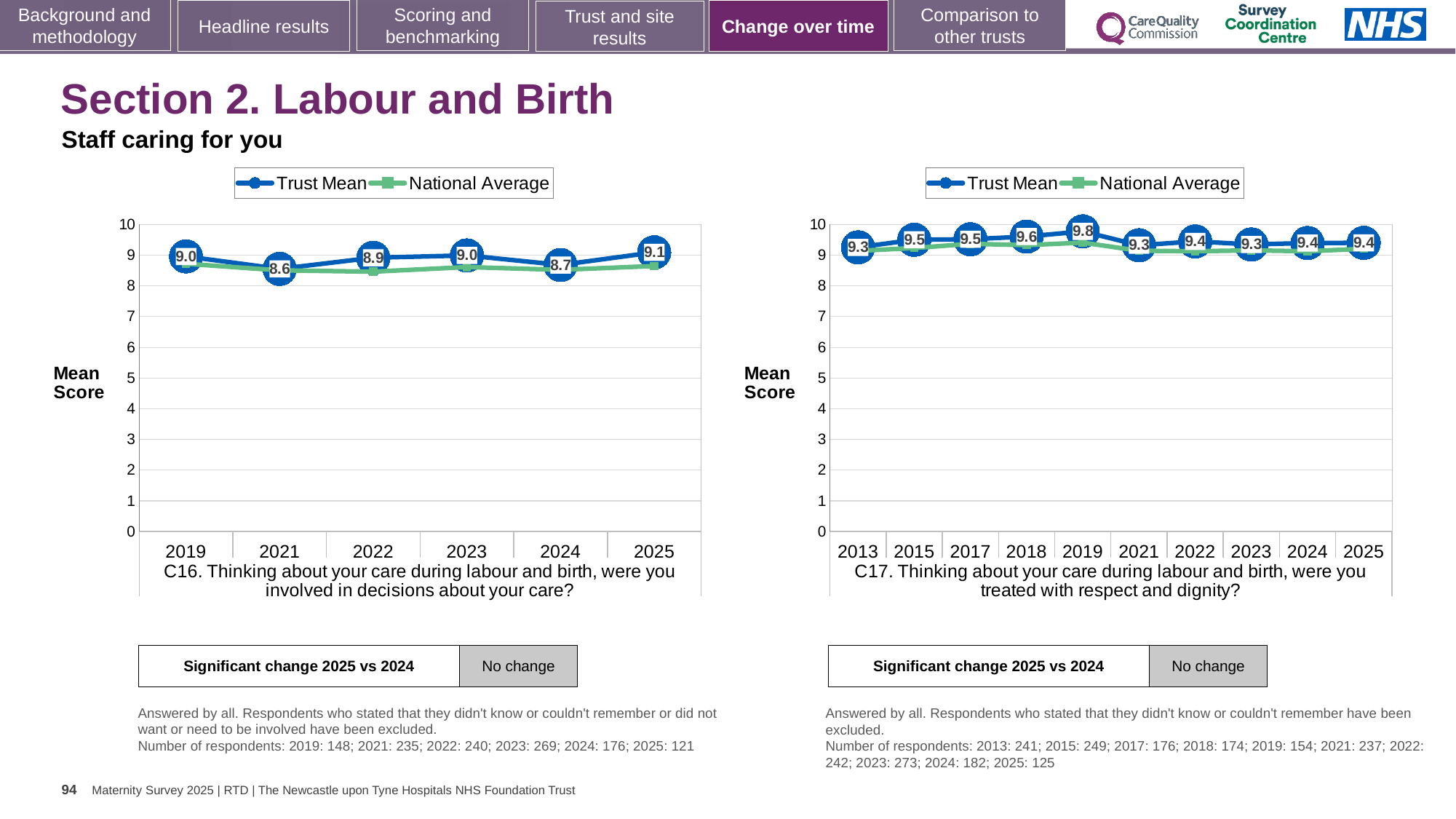
How many series does the legend of the C17 chart on the right list? 2 In the C17 chart on the right, what is the Trust Mean for 2019? 9.8 In the C17 chart on the right, which year has the highest Trust Mean? 2019 In the C16 chart on the left, how many years are shown on the x axis? 6 In the C17 chart on the right, how many years are shown on the x axis? 10 In the C16 chart on the left, which year has the lowest Trust Mean? 2021 In the C16 chart on the left, what is the Trust Mean for 2021? 8.6 In the C16 chart on the left, which year has the highest Trust Mean? 2025 In the C16 chart on the left, what is the Trust Mean for 2025? 9.1 What kind of chart is the C16 chart on the left? Line chart In the C17 chart on the right, is the Trust Mean for 2018 greater or less than 9? greater In the C16 chart on the left, what is the difference between the Trust Mean for 2025 and 2024? 0.4